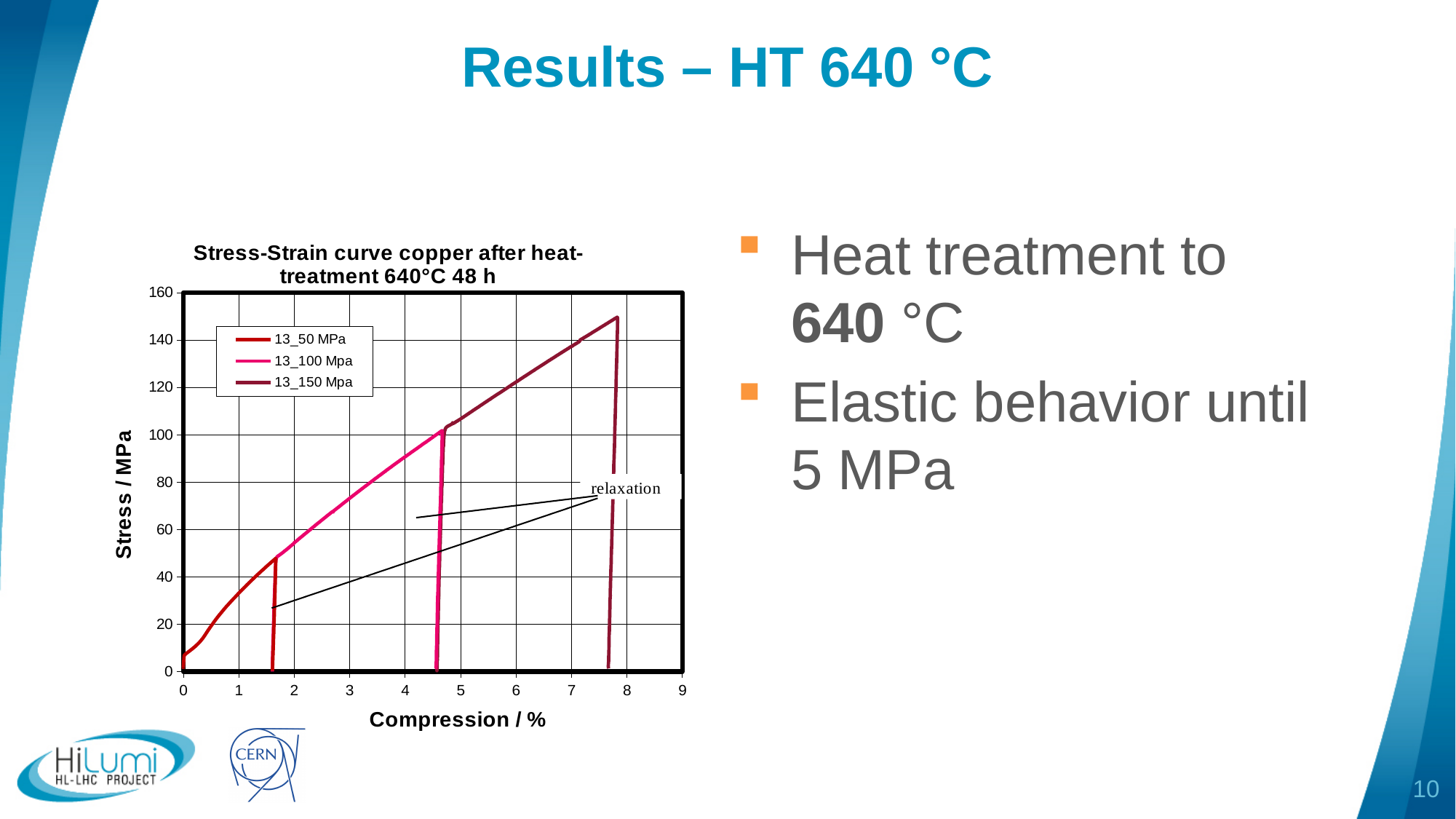
What kind of chart is shown on the slide? line chart Is the compression at which the 13_150 Mpa series reaches its peak greater or less than 7? greater Which series reaches the highest stress in the chart? 13_150 Mpa Is the peak stress of the 13_50 MPa series greater or less than 60? less Along the loading curve, does stress rise or fall as compression increases? rise Is the peak stress of the 13_150 Mpa series greater or less than 140? greater How many series does the legend of the chart list? 3 What is the label of the y axis of the chart? Stress / MPa Which series reaches a higher peak stress, 13_100 Mpa or 13_50 MPa? 13_100 Mpa What is the title of the chart? Stress-Strain curve copper after heat-treatment 640°C 48 h Which series reaches the lowest peak stress in the chart? 13_50 MPa